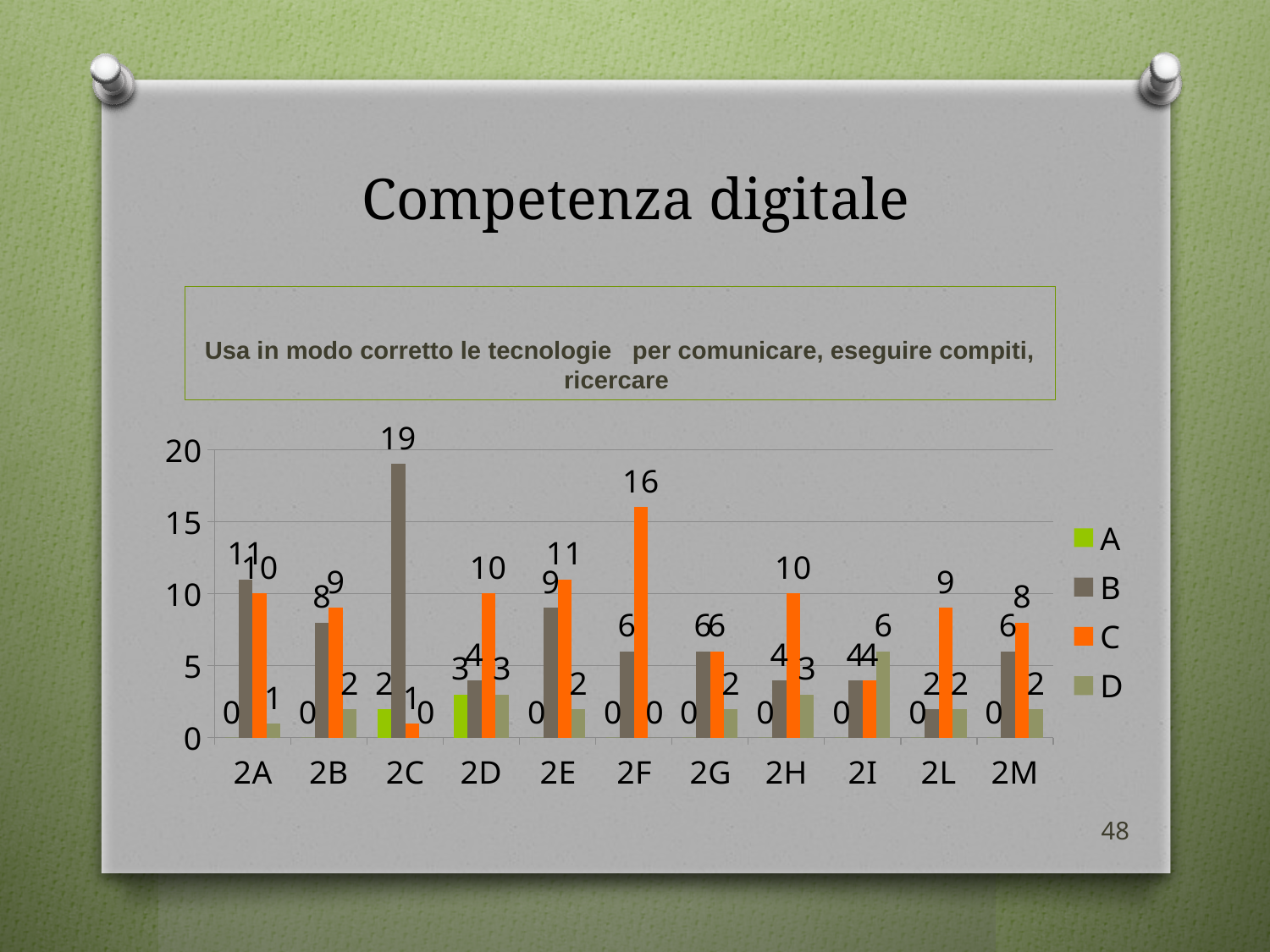
What is the value of series D for category 2I? 6 How many series does the legend list? 4 For category 2A, which is larger: series B or series C? B Which category has the highest value for series B? 2C What is the title of the slide? Competenza digitale What is the value of series B for category 2C? 19 How many categories are shown on the x axis? 11 Which category has the highest value for series C? 2F What is the difference between series B and series C for category 2C? 18 What is the value of series C for category 2F? 16 Is the value of series B for category 2C greater or less than 15? greater What kind of chart is shown on the slide? bar chart